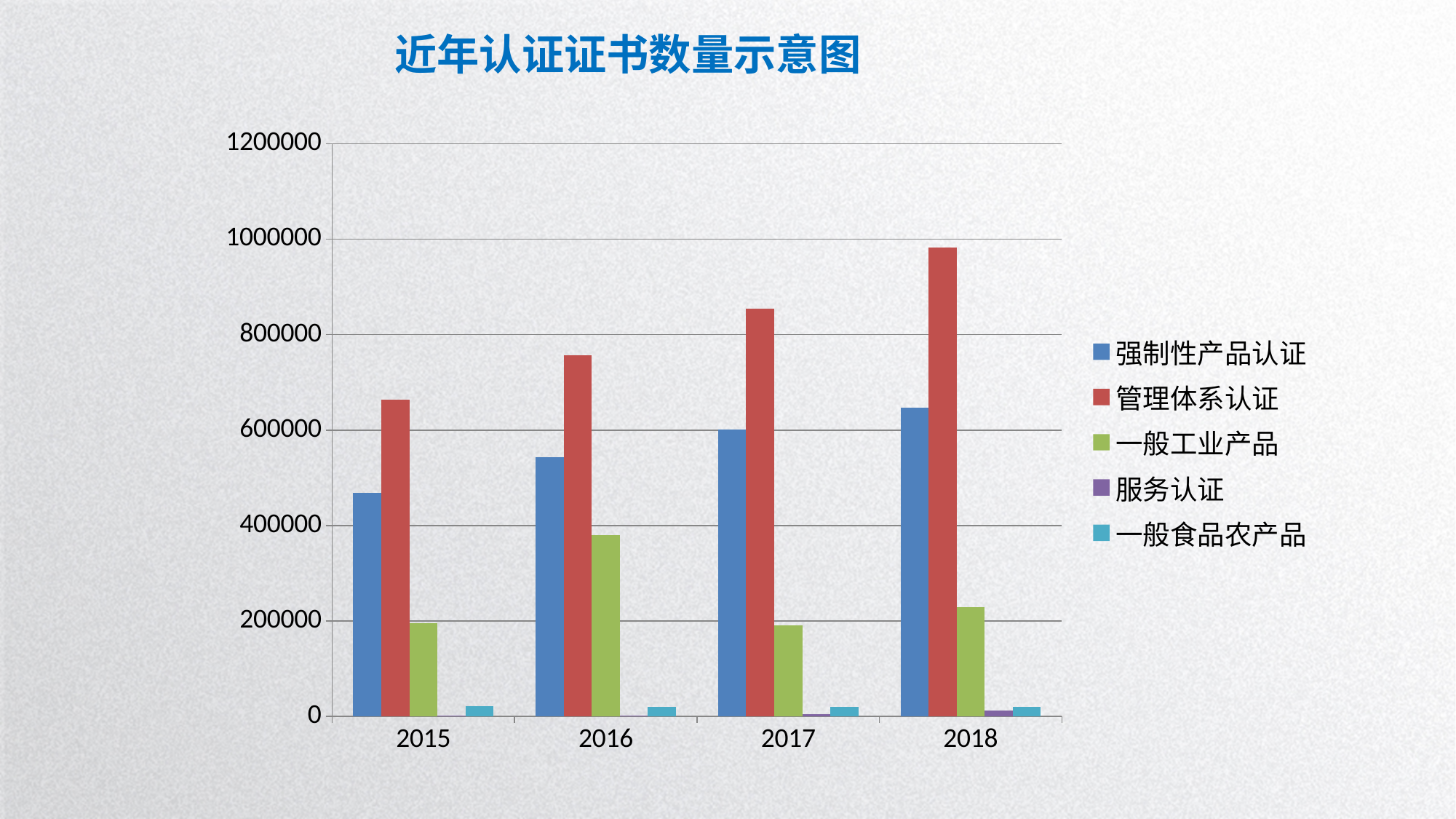
How many series does the legend list? 5 Do the values for 管理体系认证 rise or fall from 2015 to 2018? rise Is the value for 强制性产品认证 in 2017 greater or less than 800000? less Is the value for 管理体系认证 in 2018 greater or less than 800000? greater Do the values for 强制性产品认证 rise or fall from 2015 to 2018? rise Which series has the highest value in 2018? 管理体系认证 What kind of chart is shown on the slide? bar chart In which year is the value for 管理体系认证 highest? 2018 What is the title of the chart? 近年认证证书数量示意图 How many years are shown on the x axis? 4 Which series has the lowest value in 2015? 服务认证 Which is larger, the value for 一般工业产品 in 2016 or in 2017? 2016